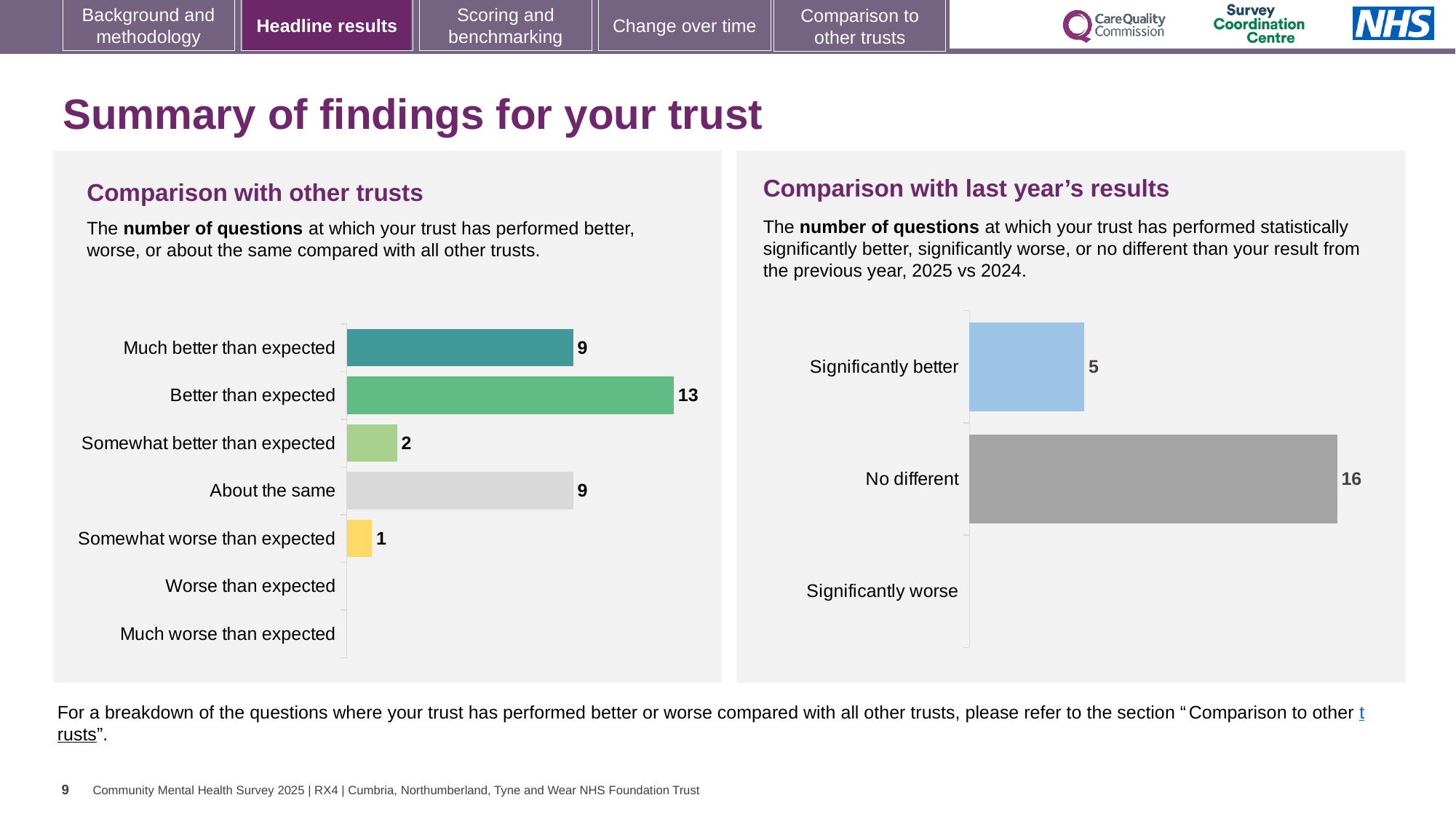
In the 'Comparison with other trusts' chart, what is the value for 'Somewhat worse than expected'? 1 In the 'Comparison with other trusts' chart, what colour is the bar for 'Somewhat worse than expected'? Yellow In the 'Comparison with last year's results' chart, what is the value for 'Significantly better'? 5 In the 'Comparison with other trusts' chart, which is larger: 'Somewhat better than expected' or 'About the same'? About the same In the 'Comparison with last year's results' chart, what is the difference between 'No different' and 'Significantly better'? 11 How many categories are listed on the y axis of the 'Comparison with other trusts' chart? 7 In the 'Comparison with last year's results' chart, what is the value for 'No different'? 16 In the 'Comparison with other trusts' chart, what is the value for 'Better than expected'? 13 In the 'Comparison with other trusts' chart, what is the difference between 'Better than expected' and 'Much better than expected'? 4 In the 'Comparison with other trusts' chart, which category has the highest value? Better than expected How many categories are listed on the y axis of the 'Comparison with last year's results' chart? 3 What kind of chart is the 'Comparison with other trusts' chart? Bar chart